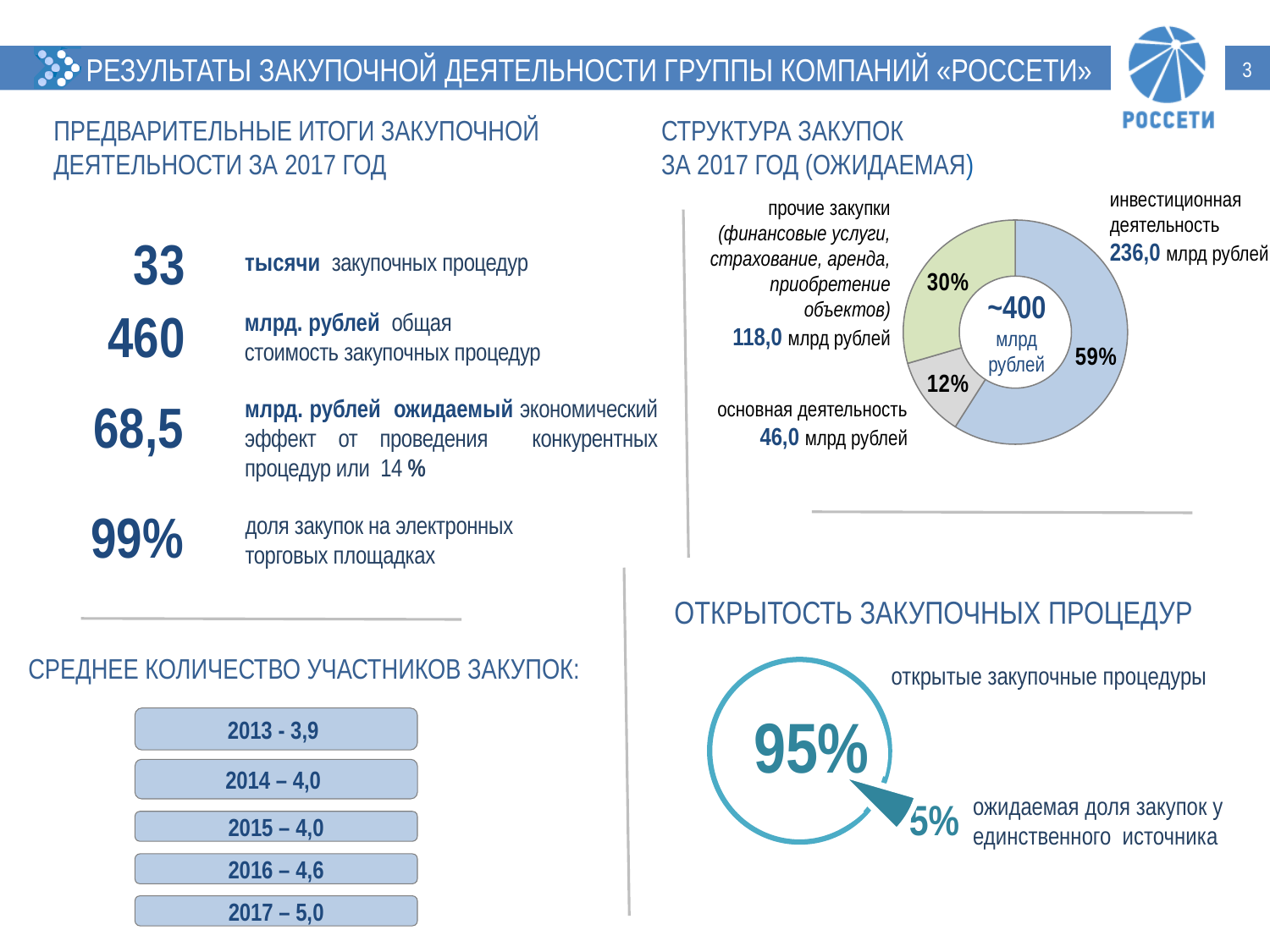
In the chart «СТРУКТУРА ЗАКУПОК ЗА 2017 ГОД (ОЖИДАЕМАЯ)», what share of the donut does «основная деятельность» take? 12% In the chart titled «СТРУКТУРА ЗАКУПОК ЗА 2017 ГОД (ОЖИДАЕМАЯ)», what kind of chart is shown? Donut (pie) chart In the chart «СТРУКТУРА ЗАКУПОК ЗА 2017 ГОД (ОЖИДАЕМАЯ)», what share of the donut does «инвестиционная деятельность» take? 59% In the chart «СТРУКТУРА ЗАКУПОК ЗА 2017 ГОД (ОЖИДАЕМАЯ)», how many slices does the donut have? 3 In the chart «СТРУКТУРА ЗАКУПОК ЗА 2017 ГОД (ОЖИДАЕМАЯ)», what total value is printed in the centre of the donut? ~400 млрд рублей In the chart «СТРУКТУРА ЗАКУПОК ЗА 2017 ГОД (ОЖИДАЕМАЯ)», what is the value for «прочие закупки»? 118,0 млрд рублей In the chart «СТРУКТУРА ЗАКУПОК ЗА 2017 ГОД (ОЖИДАЕМАЯ)», what is the difference in млрд рублей between «инвестиционная деятельность» and «основная деятельность»? 190,0 млрд рублей In the chart «СТРУКТУРА ЗАКУПОК ЗА 2017 ГОД (ОЖИДАЕМАЯ)», what is the value for «инвестиционная деятельность»? 236,0 млрд рублей In the chart «СТРУКТУРА ЗАКУПОК ЗА 2017 ГОД (ОЖИДАЕМАЯ)», which category has the largest slice? инвестиционная деятельность In the circle graphic under «ОТКРЫТОСТЬ ЗАКУПОЧНЫХ ПРОЦЕДУР», what share is shown for «открытые закупочные процедуры»? 95% In the chart «СТРУКТУРА ЗАКУПОК ЗА 2017 ГОД (ОЖИДАЕМАЯ)», which category has the smallest slice? основная деятельность In the chart «СТРУКТУРА ЗАКУПОК ЗА 2017 ГОД (ОЖИДАЕМАЯ)», what is the value for «основная деятельность»? 46,0 млрд рублей